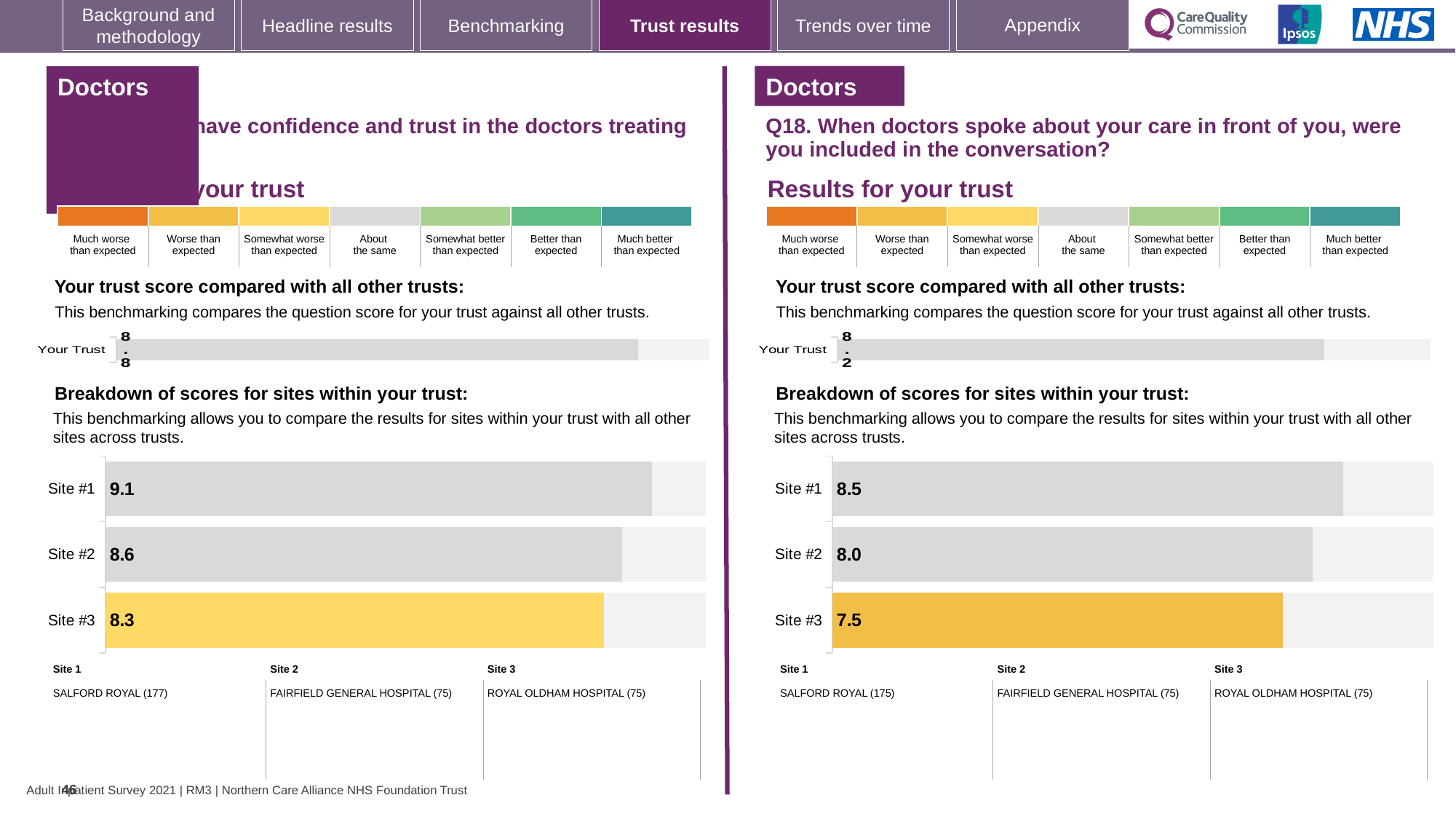
In the Q18 site breakdown chart on the right, what is the score for Site #3? 7.5 In the left-hand site breakdown chart, which site has the highest score? Site #1 In the left-hand site breakdown chart, what is the score for Site #1? 9.1 In the left-hand site breakdown chart, what is the difference between the scores for Site #1 and Site #3? 0.8 In the Q18 site breakdown chart on the right, what is the difference between the scores for Site #1 and Site #2? 0.5 How many sites are shown in the Q18 site breakdown chart on the right? 3 In the left-hand 'Your trust score compared with all other trusts' chart, what is the score for Your Trust? 8.8 In the left-hand site breakdown chart, do the scores rise or fall from Site #1 to Site #3? Fall What kind of chart is used for the breakdown of scores for sites within your trust? Bar chart In the Q18 'Your trust score compared with all other trusts' chart on the right, what is the score for Your Trust? 8.2 In the Q18 site breakdown chart on the right, which site has the lowest score? Site #3 Is the score for Site #2 higher in the left-hand site breakdown chart or in the Q18 chart on the right? Left-hand chart